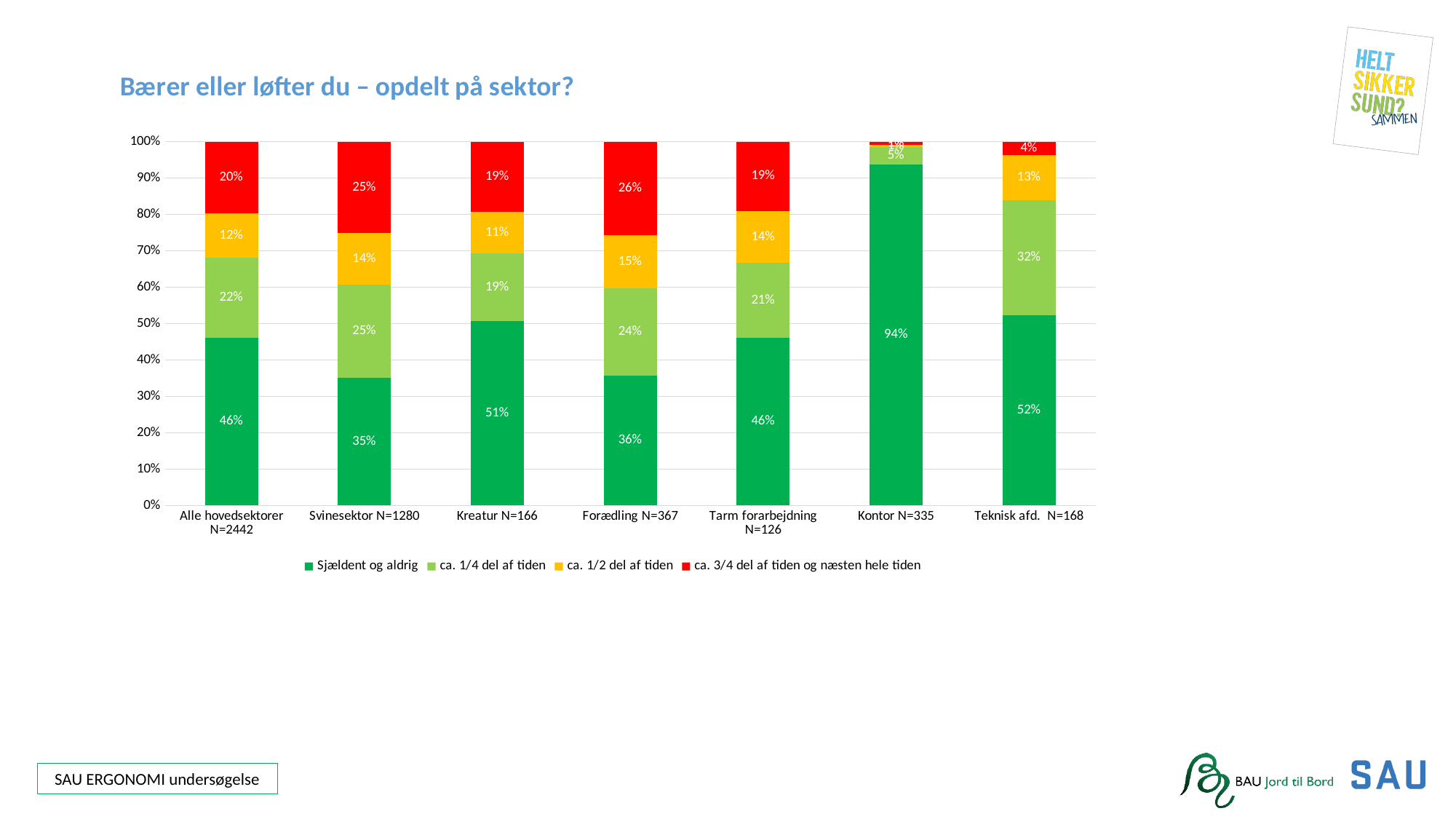
How many sector categories are shown on the x axis? 7 What is the title of the chart? Bærer eller løfter du – opdelt på sektor? What is the difference between the 'Sjældent og aldrig' values for Kreatur N=166 and Forædling N=367? 15% What is the 'ca. 1/2 del af tiden' value for Svinesektor N=1280? 14% Which is larger: the 'ca. 3/4 del af tiden og næsten hele tiden' value for Svinesektor N=1280 or for Alle hovedsektorer N=2442? Svinesektor N=1280 What is the 'ca. 3/4 del af tiden og næsten hele tiden' value for Forædling N=367? 26% What is the 'ca. 1/4 del af tiden' value for Teknisk afd. N=168? 32% How many series does the legend list? 4 Which sector has the lowest 'Sjældent og aldrig' value? Svinesektor N=1280 Which sector has the highest 'Sjældent og aldrig' value? Kontor N=335 What is the 'Sjældent og aldrig' value for Kontor N=335? 94% What kind of chart is shown on the slide? Stacked bar chart